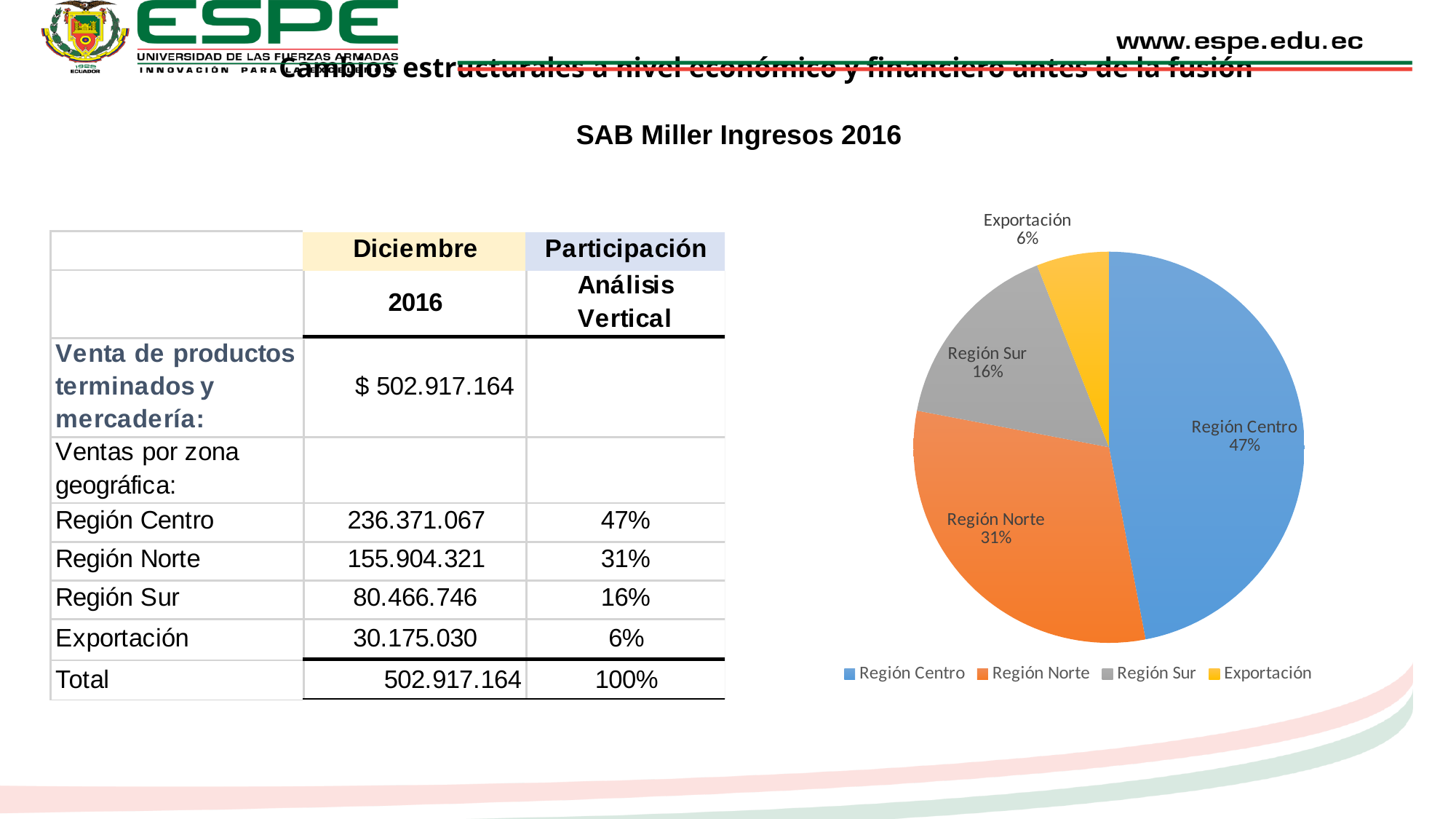
How many entries does the legend of the pie chart list? 4 Which is larger in the pie chart, Región Sur or Exportación? Región Sur How many slices does the pie chart have? 4 What colour is the Región Norte slice in the pie chart? orange Which slice of the pie chart is the smallest? Exportación What share of the pie does Región Norte represent? 31% What share of the pie does Región Centro represent? 47% What share of the pie does Región Sur represent? 16% What is the difference in percentage points between Región Centro and Región Norte? 16% What type of chart is shown on the slide? pie chart Which slice of the pie chart is the largest? Región Centro